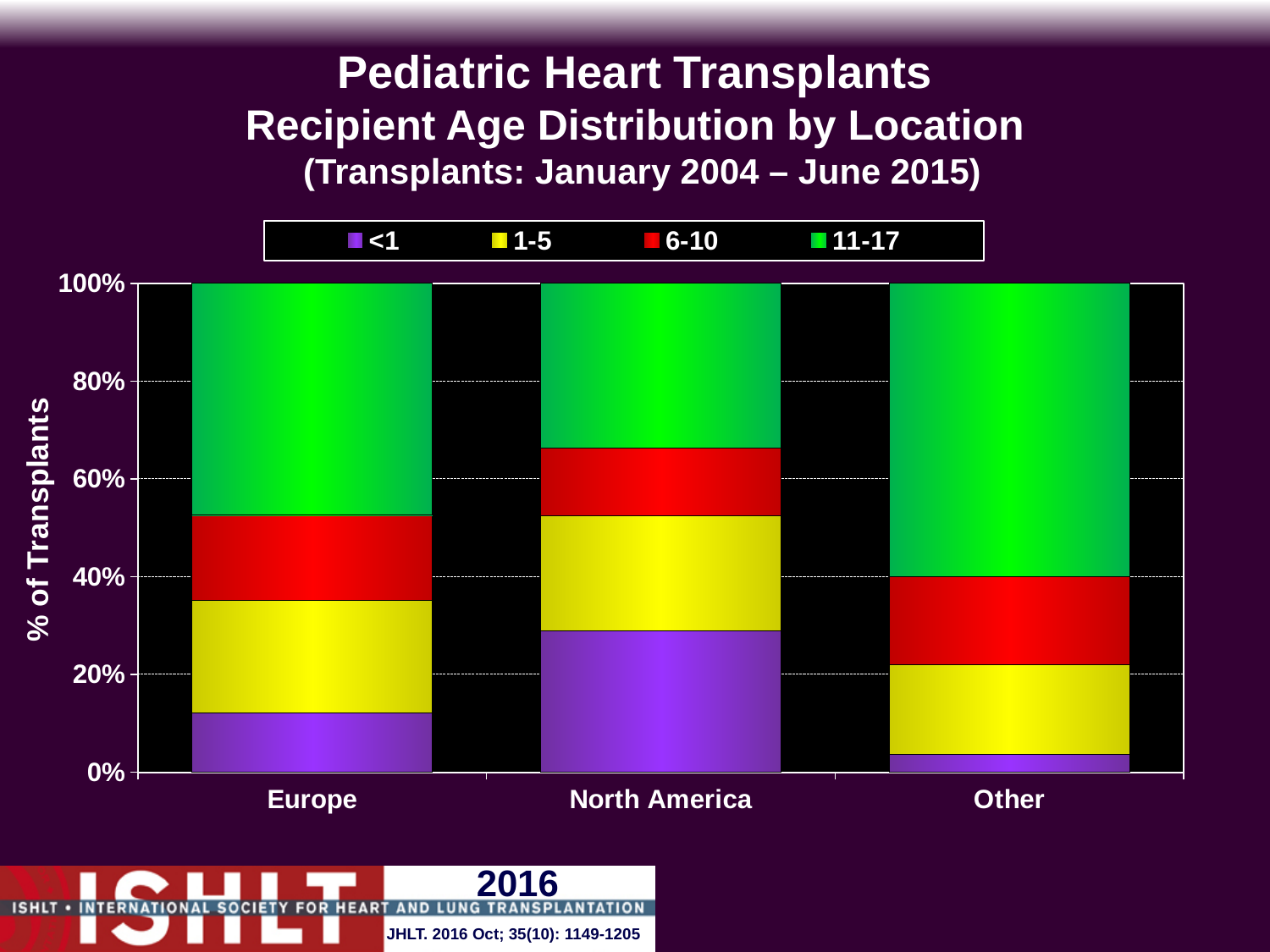
How many locations are shown on the x axis of the chart? 3 Which location has the largest share of recipients aged <1? North America How many age groups does the legend list? 4 Is the share of recipients aged <1 in Europe greater or less than 20%? less Is the share of recipients aged 11-17 in Other greater or less than 40%? greater What is the label of the y axis? % of Transplants Which location has the largest share of recipients aged 11-17? Other Is the share of recipients aged <1 in North America greater or less than 20%? greater What kind of chart is shown on the slide? stacked bar chart Which location has the smallest share of recipients aged <1? Other Which location has the smallest share of recipients aged 11-17? North America Which location has a larger share of recipients aged <1, Europe or Other? Europe